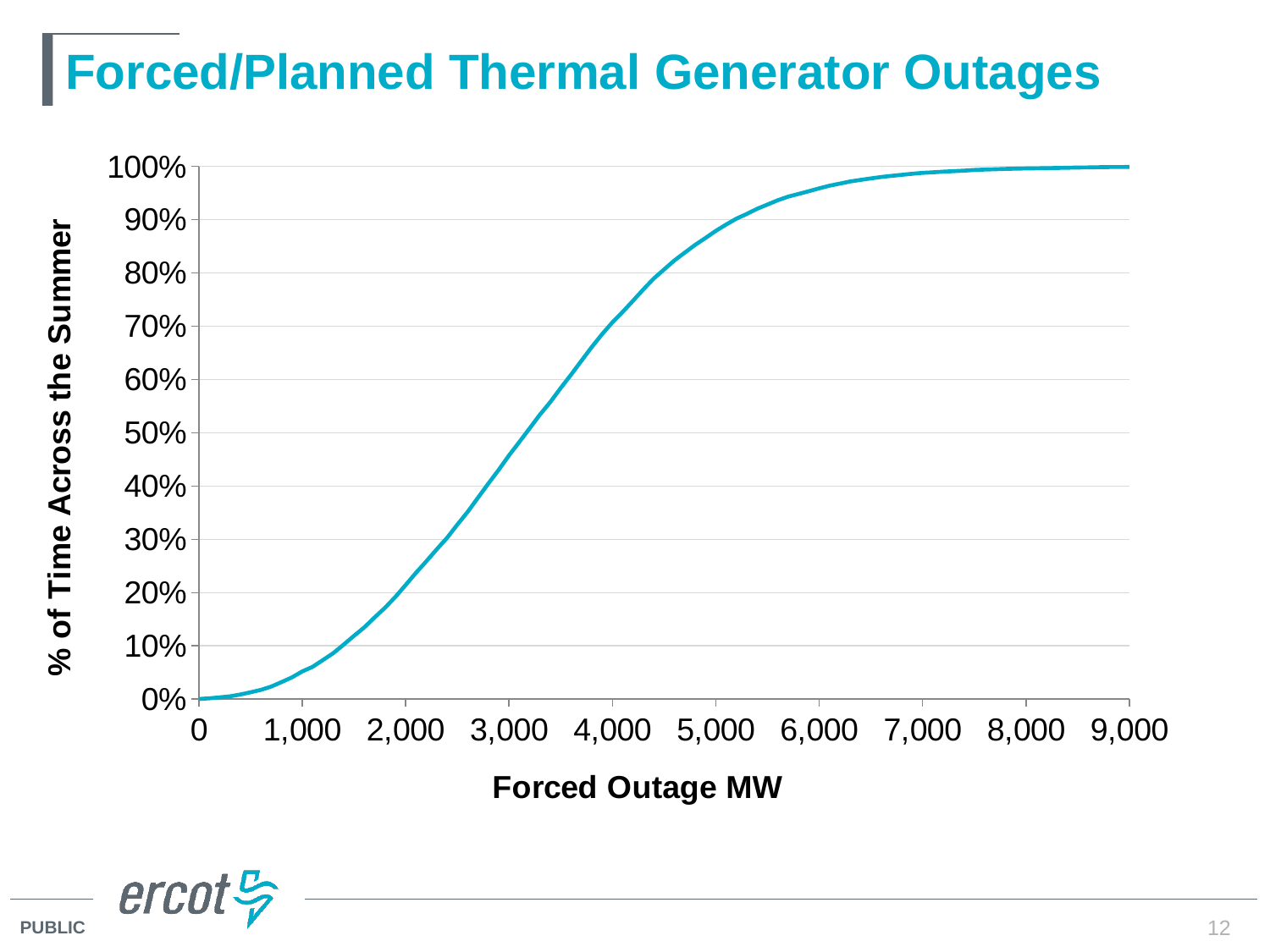
What is the title of the chart? Forced/Planned Thermal Generator Outages Is the value at 6,000 Forced Outage MW greater or less than 90%? greater Is the value at 3,000 Forced Outage MW greater or less than 40%? greater Is the value at 5,000 Forced Outage MW greater or less than 80%? greater What is the label of the x axis? Forced Outage MW What kind of chart is shown on the slide? line chart Do the values rise or fall as Forced Outage MW increases along the x axis? rise